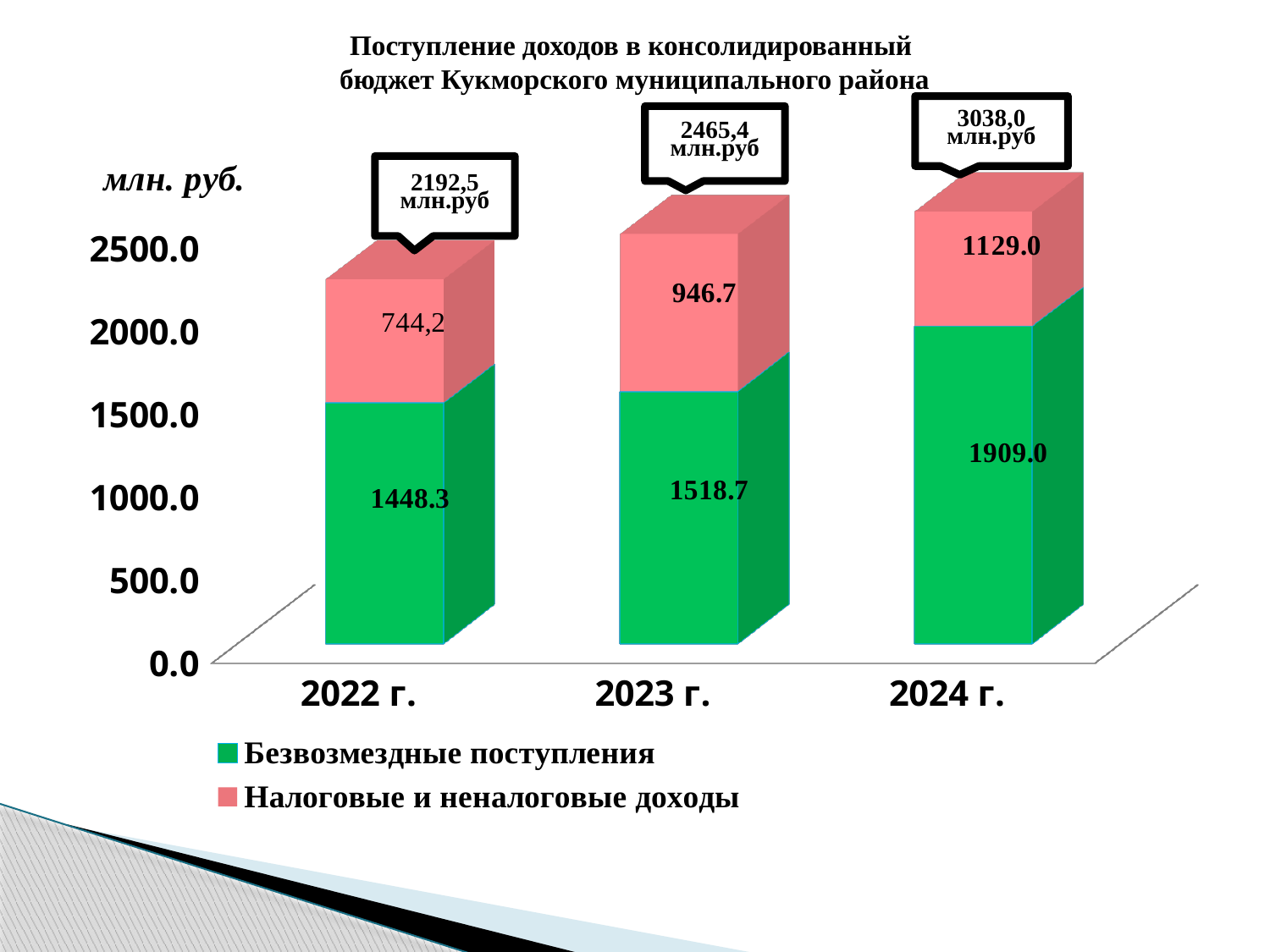
Which year has the lowest value for Налоговые и неналоговые доходы? 2022 г. What is the value of Безвозмездные поступления for 2022 г.? 1448.3 What is the difference between Безвозмездные поступления in 2024 г. and 2023 г.? 390.3 What total is shown in the callout above the 2023 г. bar? 2465,4 млн.руб What is the value of Налоговые и неналоговые доходы for 2023 г.? 946.7 What is the value of Безвозмездные поступления for 2024 г.? 1909.0 How many series does the legend list? 2 Which is larger: Безвозмездные поступления in 2023 г. or Налоговые и неналоговые доходы in 2024 г.? Безвозмездные поступления in 2023 г. What kind of chart is shown on the slide? Stacked bar chart Which year has the highest value for Безвозмездные поступления? 2024 г. What is the value of Налоговые и неналоговые доходы for 2024 г.? 1129.0 What total is shown in the callout above the 2024 г. bar? 3038,0 млн.руб